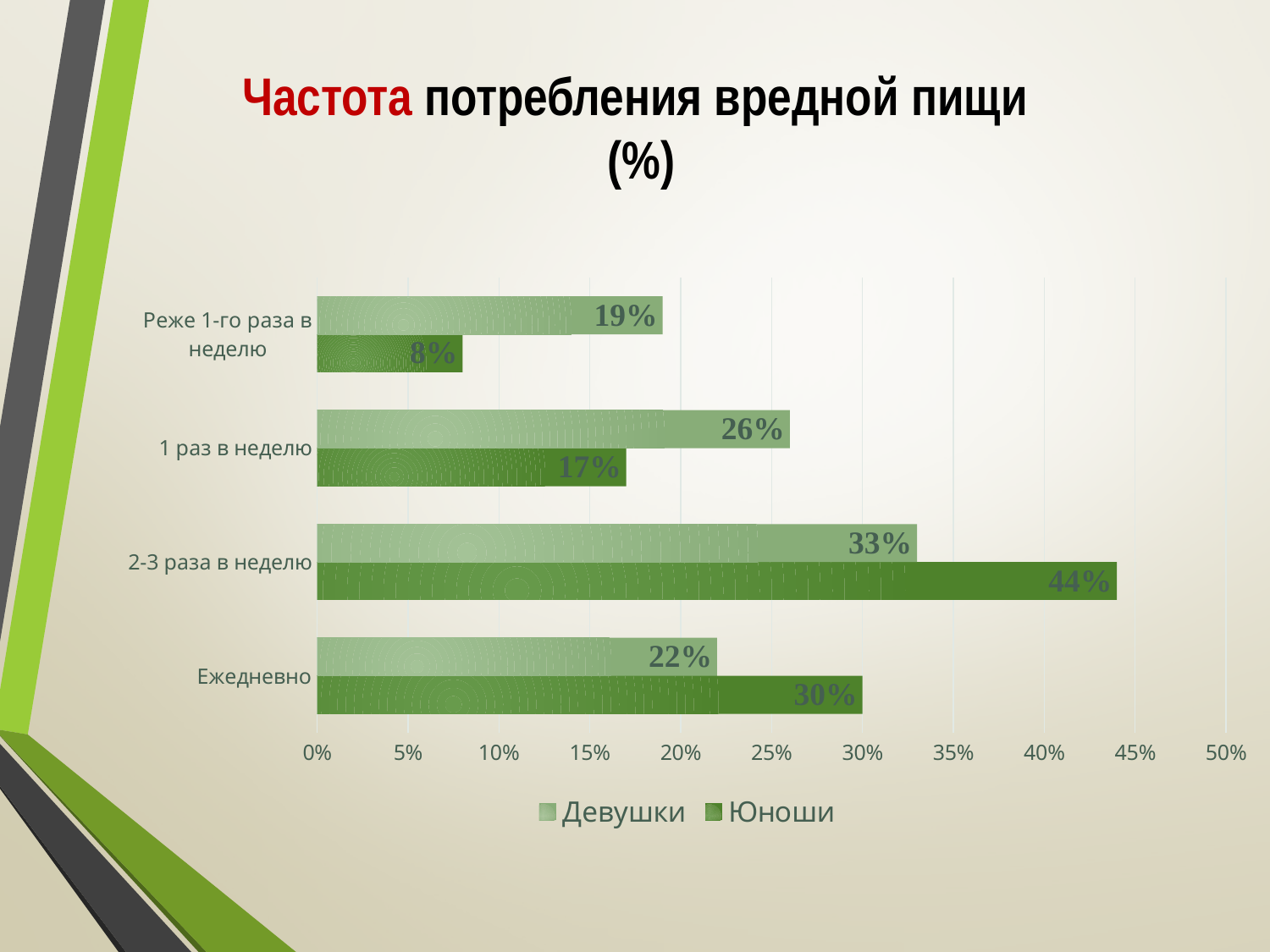
What is the value for Юноши in the category «Реже 1-го раза в неделю»? 8% What is the title of the chart? Частота потребления вредной пищи (%) In the category «1 раз в неделю», which series has the larger value, Девушки or Юноши? Девушки How many series does the legend list? 2 What is the value for Девушки in the category «2-3 раза в неделю»? 33% What is the value for Девушки in the category «1 раз в неделю»? 26% What is the value for Юноши in the category «Ежедневно»? 30% Which category has the highest value for Юноши? 2-3 раза в неделю What kind of chart is shown on the slide? Bar chart What is the difference between Юноши and Девушки in the category «2-3 раза в неделю»? 11% How many categories are shown on the chart? 4 Which category has the lowest value for Девушки? Реже 1-го раза в неделю